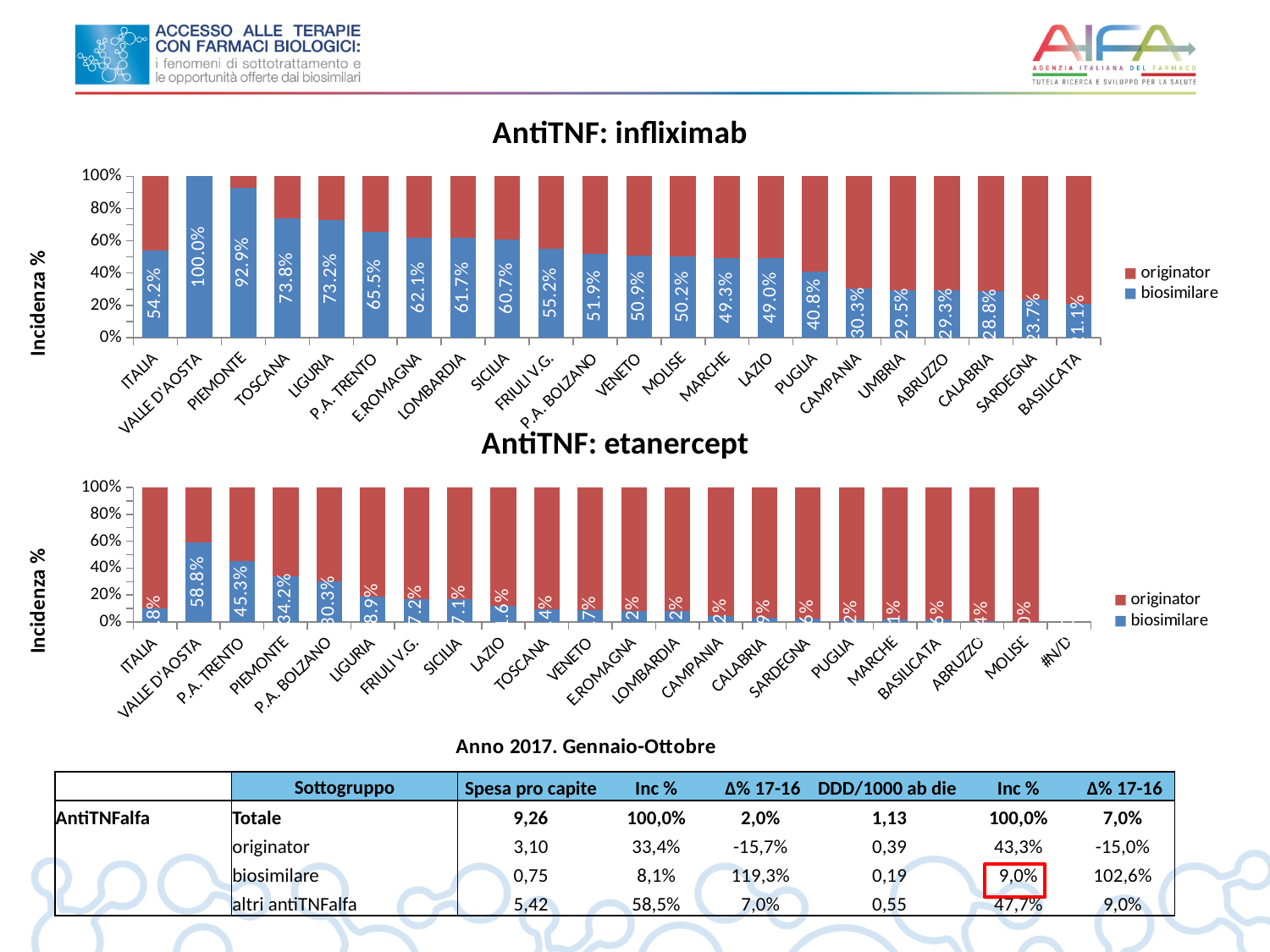
In the 'AntiTNF: infliximab' chart, what is the difference in biosimilare share between VALLE D'AOSTA and PIEMONTE? 7.1 percentage points In the 'AntiTNF: etanercept' chart, is the biosimilare share for ITALIA greater or less than 20%? less In the 'AntiTNF: infliximab' chart, which region has the highest biosimilare share? VALLE D'AOSTA In the 'AntiTNF: infliximab' chart, which region has the lowest biosimilare share? BASILICATA What kind of chart is 'AntiTNF: infliximab'? Stacked bar chart How many series does the legend of the 'AntiTNF: etanercept' chart list? 2 In the 'AntiTNF: infliximab' chart, which has a larger biosimilare share, PUGLIA or CAMPANIA? PUGLIA In the 'AntiTNF: etanercept' chart, what is the biosimilare share for P.A. TRENTO? 45.3% In the 'AntiTNF: infliximab' chart, what is the biosimilare share for ITALIA? 54.2% In the 'AntiTNF: infliximab' chart, what is the biosimilare share for PIEMONTE? 92.9% In the 'AntiTNF: etanercept' chart, what is the biosimilare share for VALLE D'AOSTA? 58.8% In the 'AntiTNF: infliximab' chart, which colour represents the originator series? Red